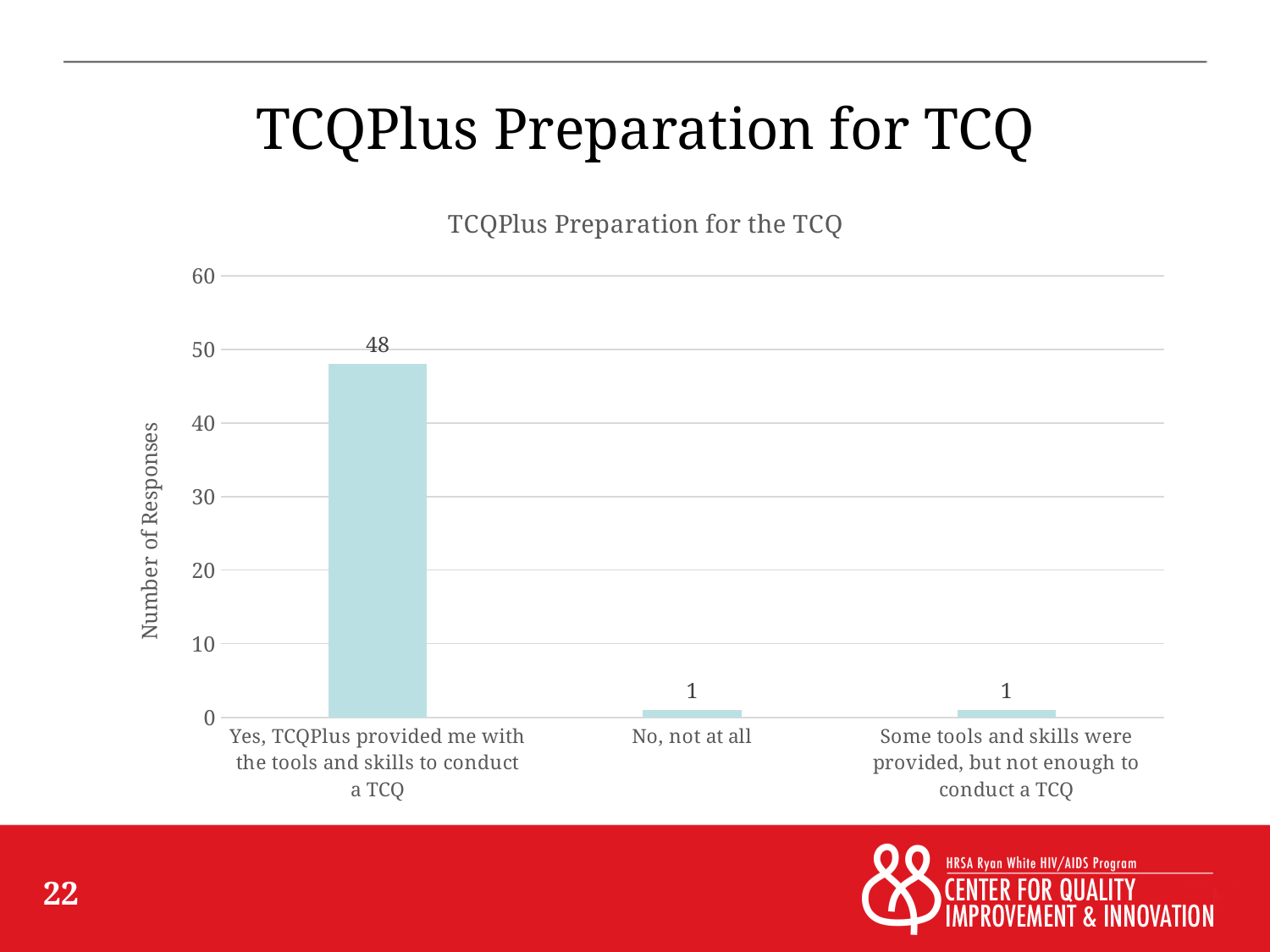
Which has more responses: "Yes, TCQPlus provided me with the tools and skills to conduct a TCQ" or "Some tools and skills were provided, but not enough to conduct a TCQ"? Yes, TCQPlus provided me with the tools and skills to conduct a TCQ What is the title of the chart? TCQPlus Preparation for the TCQ How many responses are shown for "No, not at all"? 1 Which category has the highest number of responses? Yes, TCQPlus provided me with the tools and skills to conduct a TCQ What kind of chart is shown on the slide? bar chart How many responses are shown for "Some tools and skills were provided, but not enough to conduct a TCQ"? 1 What is the label of the vertical axis? Number of Responses How many categories are shown on the x axis? 3 What is the total number of responses across all three categories? 50 Is the value for "Yes, TCQPlus provided me with the tools and skills to conduct a TCQ" greater or less than 40? greater How many responses are shown for "Yes, TCQPlus provided me with the tools and skills to conduct a TCQ"? 48 What is the difference in responses between "Yes, TCQPlus provided me with the tools and skills to conduct a TCQ" and "No, not at all"? 47